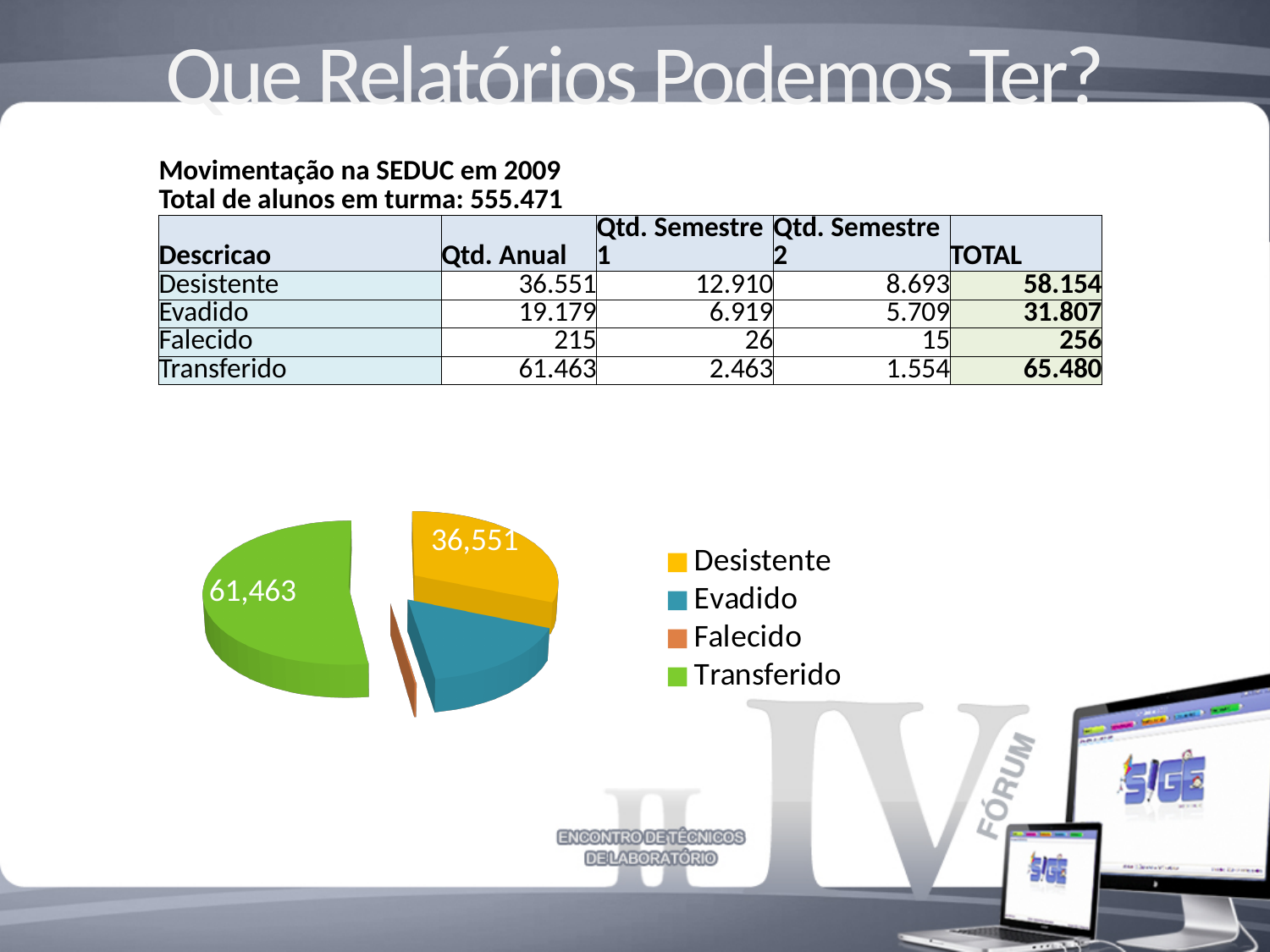
How many slices does the pie chart have? 4 Which category has the smallest slice in the pie chart? Falecido What colour is the Transferido slice in the pie chart? Green Which slice is larger in the pie chart, Desistente or Evadido? Desistente Which category has the largest slice in the pie chart? Transferido How many entries does the pie chart legend list? 4 Which slice is larger in the pie chart, Evadido or Falecido? Evadido What is the difference between the Transferido and Desistente values labelled on the pie chart? 24,912 What value is labelled on the Desistente slice of the pie chart? 36,551 Which category is shown in yellow in the pie chart legend? Desistente What value is labelled on the Transferido slice of the pie chart? 61,463 What type of chart is shown on the slide? Pie chart